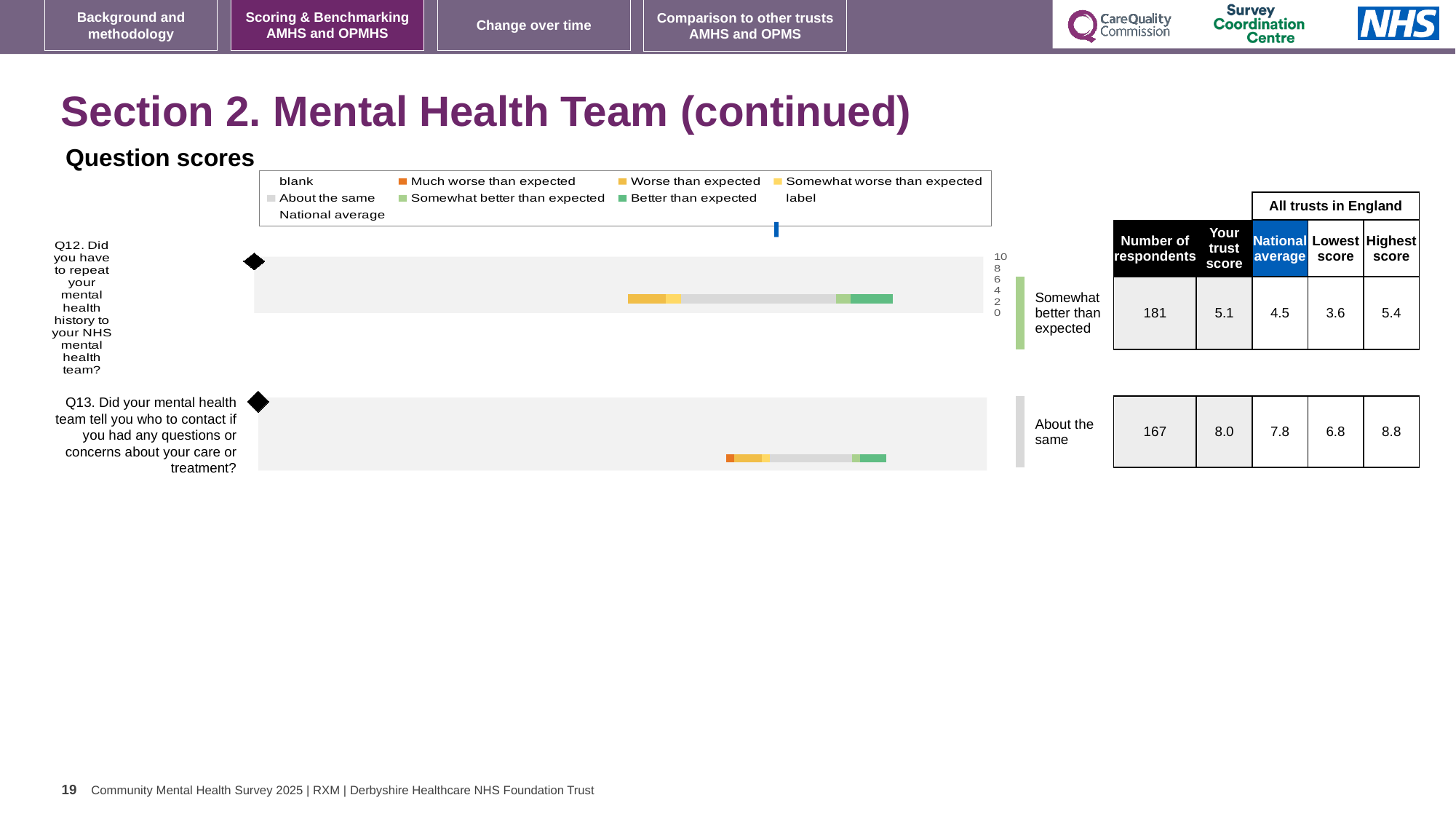
Which question has the higher trust score, Q12 or Q13? Q13 How many respondents answered Q13? 167 What kind of chart is used to show the question scores for Q12 and Q13? Bar chart How many questions are plotted in the question scores chart? 2 What is the trust score for Q13 (who to contact with questions or concerns)? 8.0 Which benchmark category is shown for Q12? Somewhat better than expected What colour does the legend use for 'Better than expected'? Green What is the difference between the highest score and the lowest score for Q13? 2.0 How much higher is the trust score than the national average for Q12? 0.6 What is the trust score for Q12 (repeating mental health history)? 5.1 What is the national average score for Q12? 4.5 Which benchmark category is shown for Q13? About the same